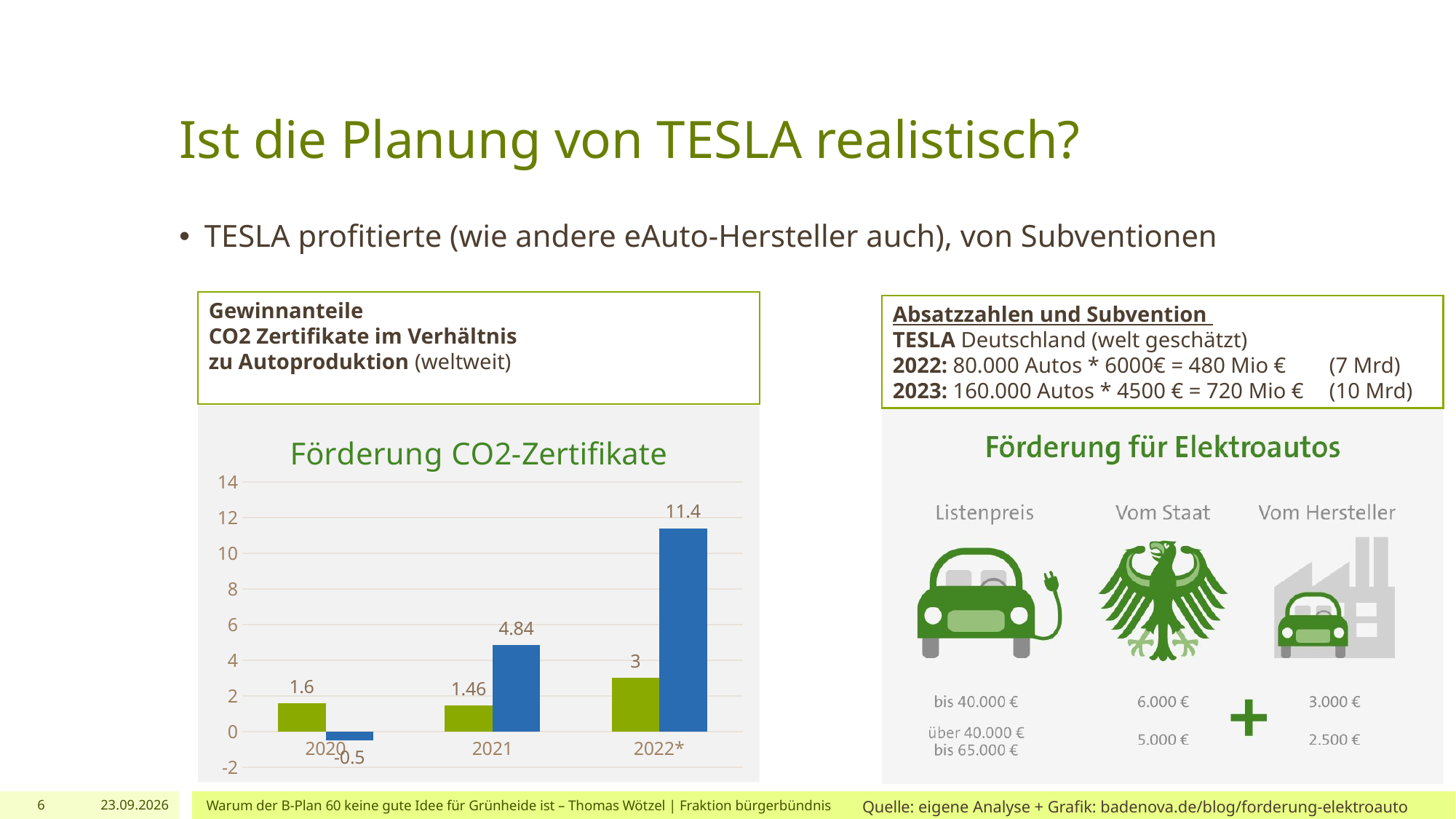
In the "Förderung CO2-Zertifikate" chart, which year has the highest blue bar? 2022* In the "Förderung CO2-Zertifikate" chart, which is larger for 2021: the green bar or the blue bar? the blue bar What type of chart is "Förderung CO2-Zertifikate"? bar chart In the "Förderung CO2-Zertifikate" chart, what is the value of the green bar for 2020? 1.6 In the "Förderung CO2-Zertifikate" chart, what is the value of the blue bar for 2020? -0.5 In the "Förderung CO2-Zertifikate" chart, which year has the lowest blue bar? 2020 In the "Förderung CO2-Zertifikate" chart, do the blue bars rise or fall from 2020 to 2022*? rise How many years are shown on the x axis of the "Förderung CO2-Zertifikate" chart? 3 In the "Förderung CO2-Zertifikate" chart, what is the value of the blue bar for 2021? 4.84 In the "Förderung CO2-Zertifikate" chart, is the blue bar for 2022* greater or less than 10? greater In the "Förderung CO2-Zertifikate" chart, what is the difference between the blue bar for 2022* and the blue bar for 2021? 6.56 In the "Förderung CO2-Zertifikate" chart, what is the value of the green bar for 2022*? 3